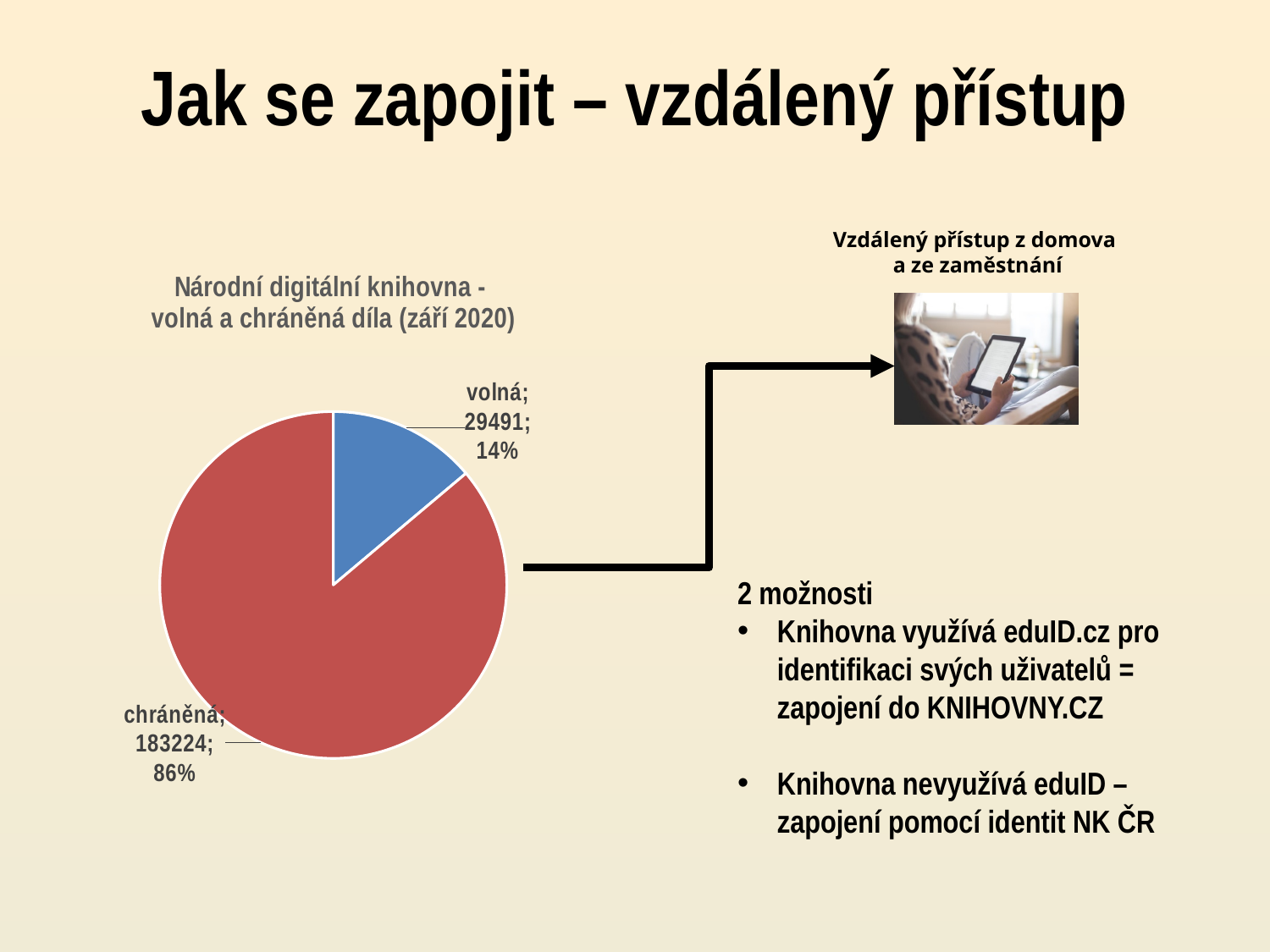
What is the difference between the 'chráněná' and 'volná' values? 153733 What is the title of the pie chart? Národní digitální knihovna - volná a chráněná díla (září 2020) What share of the pie does the 'volná' slice represent? 14% How many slices does the pie chart have? 2 What is the value for the 'volná' slice? 29491 Which is larger, the value for 'volná' or for 'chráněná'? chráněná What colour is the 'volná' slice? blue Which slice is the largest in the pie chart? chráněná What type of chart is shown on the slide? pie chart What is the value for the 'chráněná' slice? 183224 What share of the pie does the 'chráněná' slice represent? 86% Which slice is the smallest in the pie chart? volná